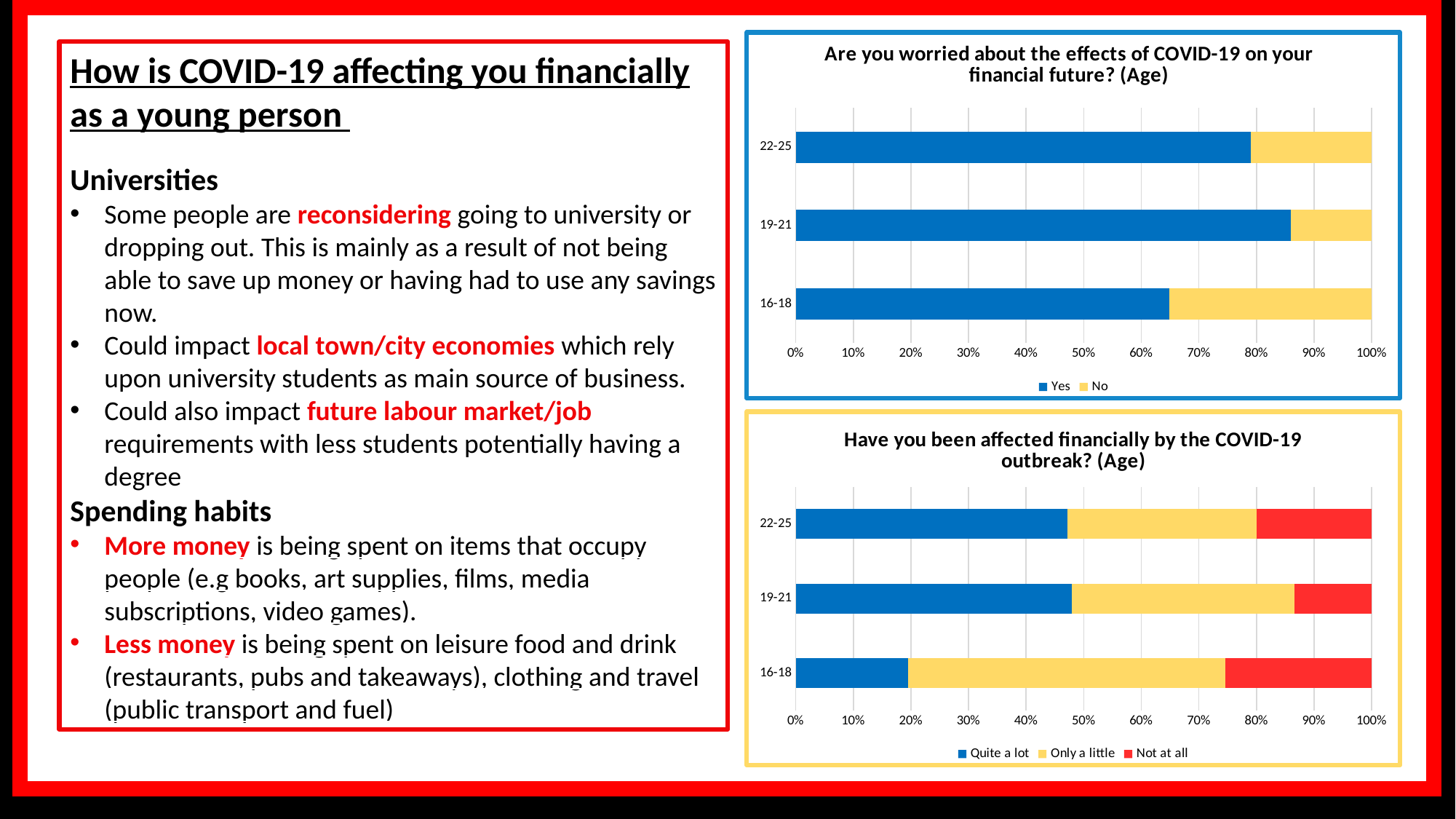
In the chart titled "Have you been affected financially by the COVID-19 outbreak? (Age)", what colour represents "Not at all"? Red In the chart titled "Have you been affected financially by the COVID-19 outbreak? (Age)", which age group has the smallest share of "Quite a lot"? 16-18 In the chart titled "Are you worried about the effects of COVID-19 on your financial future? (Age)", is the Yes share for 19-21 greater or less than 80%? greater In the chart titled "Have you been affected financially by the COVID-19 outbreak? (Age)", how many series does the legend list? 3 In the chart titled "Have you been affected financially by the COVID-19 outbreak? (Age)", is the "Quite a lot" share for 16-18 greater or less than 30%? less In the chart titled "Are you worried about the effects of COVID-19 on your financial future? (Age)", which age group has the lowest share of Yes? 16-18 In the chart titled "Are you worried about the effects of COVID-19 on your financial future? (Age)", is the Yes share for 16-18 greater or less than 70%? less In the chart titled "Have you been affected financially by the COVID-19 outbreak? (Age)", which age group has the largest "Not at all" share, 16-18 or 19-21? 16-18 In the chart titled "Are you worried about the effects of COVID-19 on your financial future? (Age)", how many series does the legend list? 2 In the chart titled "Are you worried about the effects of COVID-19 on your financial future? (Age)", what kind of chart is shown? Stacked bar chart In the chart titled "Are you worried about the effects of COVID-19 on your financial future? (Age)", how many age groups are shown? 3 In the chart titled "Are you worried about the effects of COVID-19 on your financial future? (Age)", which age group has the highest share of Yes? 19-21